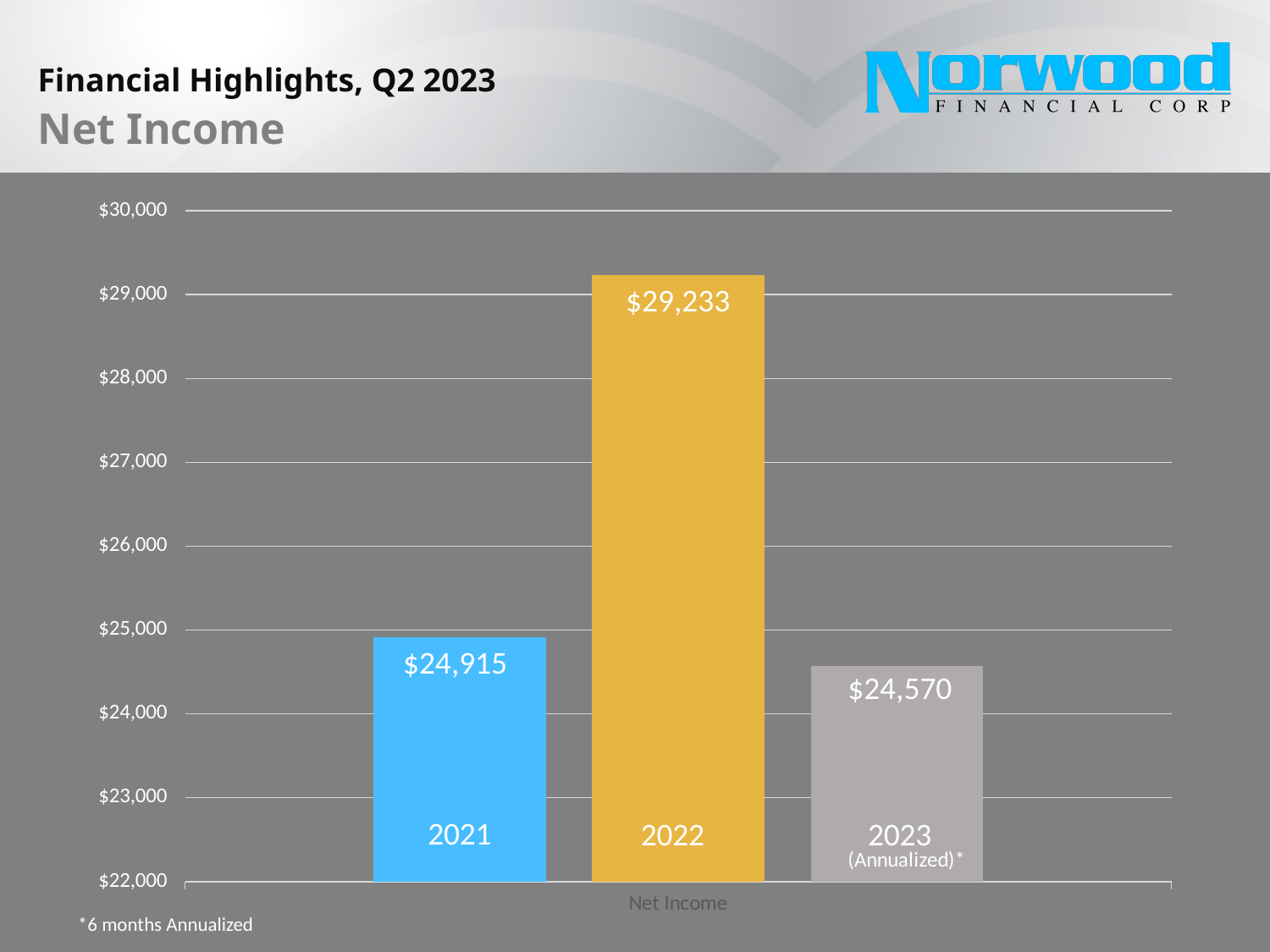
What is the net income value shown for 2022? $29,233 What is the difference between the 2022 and 2021 net income values? $4,318 How many bars are shown on the chart? 3 What is the difference between the 2021 and 2023 (Annualized) net income values? $345 What is the net income value shown for 2021? $24,915 Which year has the highest net income on the chart? 2022 Which year has the lowest net income on the chart? 2023 (Annualized) Which is larger, the net income for 2021 or for 2023 (Annualized)? 2021 What is the title of the chart on the slide? Net Income Is the net income for 2022 greater or less than $29,000? greater What is the net income value shown for 2023 (Annualized)? $24,570 What kind of chart is shown on the slide? Bar chart